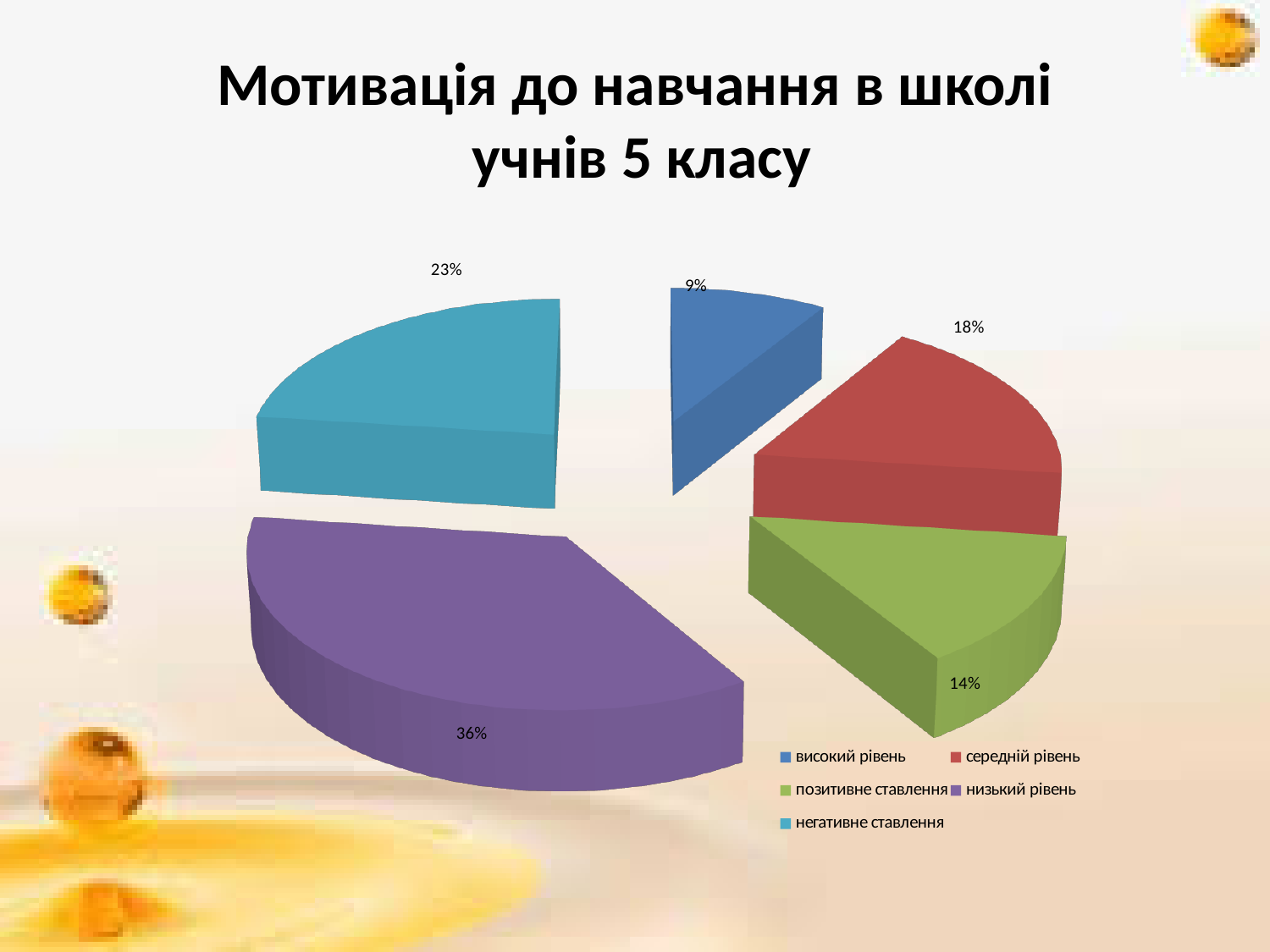
Which category has the largest slice of the pie? низький рівень What type of chart is shown on the slide? pie chart Which category has the smallest slice of the pie? високий рівень What percentage is shown for "високий рівень"? 9% What percentage is shown for "негативне ставлення"? 23% What is the title of the chart on the slide? Мотивація до навчання в школі учнів 5 класу What percentage of the pie is labelled for "низький рівень"? 36% What percentage is shown for "позитивне ставлення"? 14% How many slices does the pie chart have? 5 Which is larger, the slice for "середній рівень" or the slice for "позитивне ставлення"? середній рівень What is the difference in percentage points between "низький рівень" and "негативне ставлення"? 13 What percentage is shown for "середній рівень"? 18%